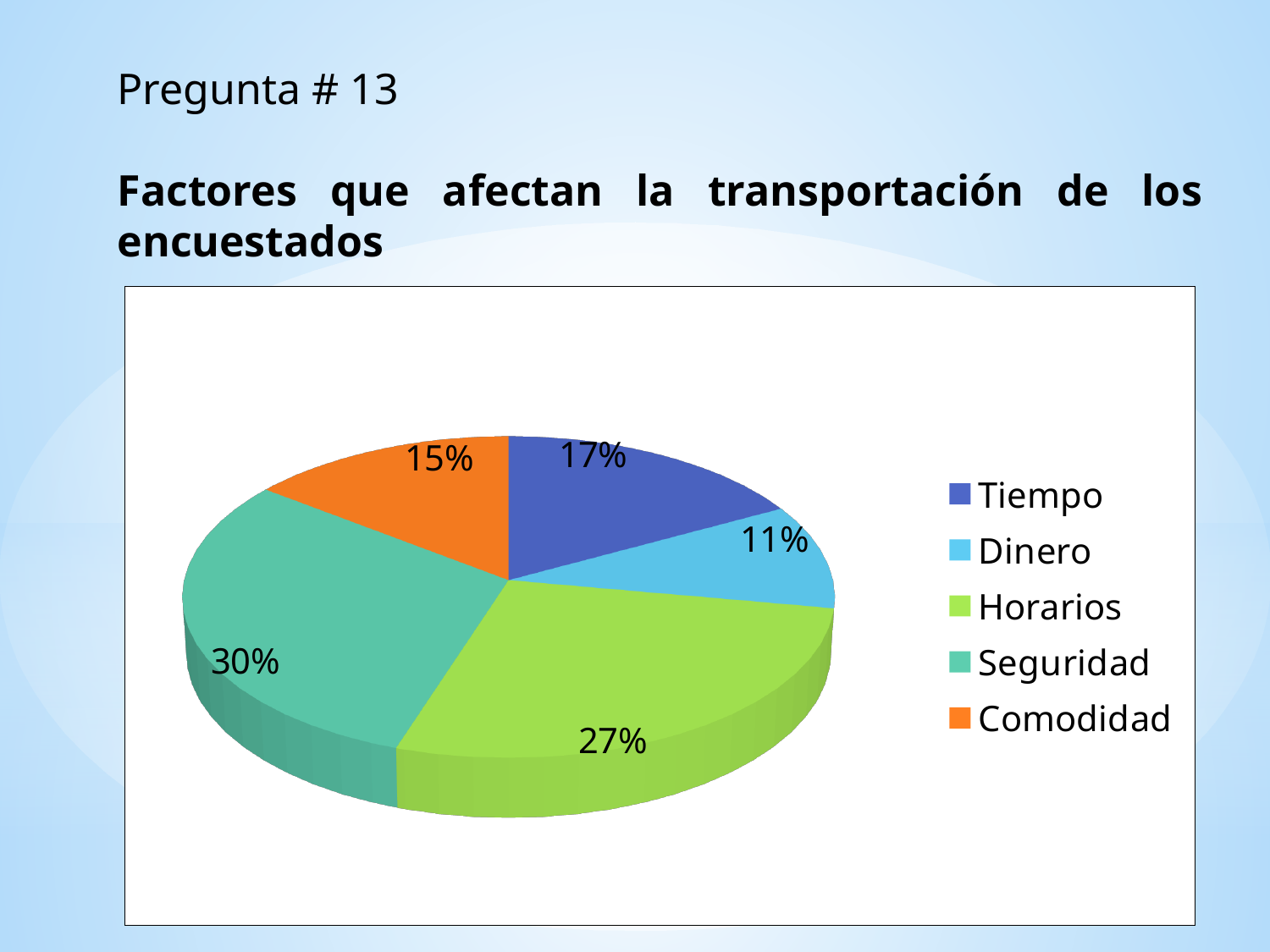
What share of the pie does Dinero have? 11% Which factor has the smallest slice of the pie? Dinero How many slices does the pie chart have? 5 Which colour represents Comodidad in the legend? orange What share of the pie does Seguridad have? 30% What is the difference in percentage points between Seguridad and Dinero? 19 What share of the pie does Horarios have? 27% Which factor has the largest slice of the pie? Seguridad Which is larger, the share for Tiempo or the share for Comodidad? Tiempo What kind of chart is shown on the slide? pie chart